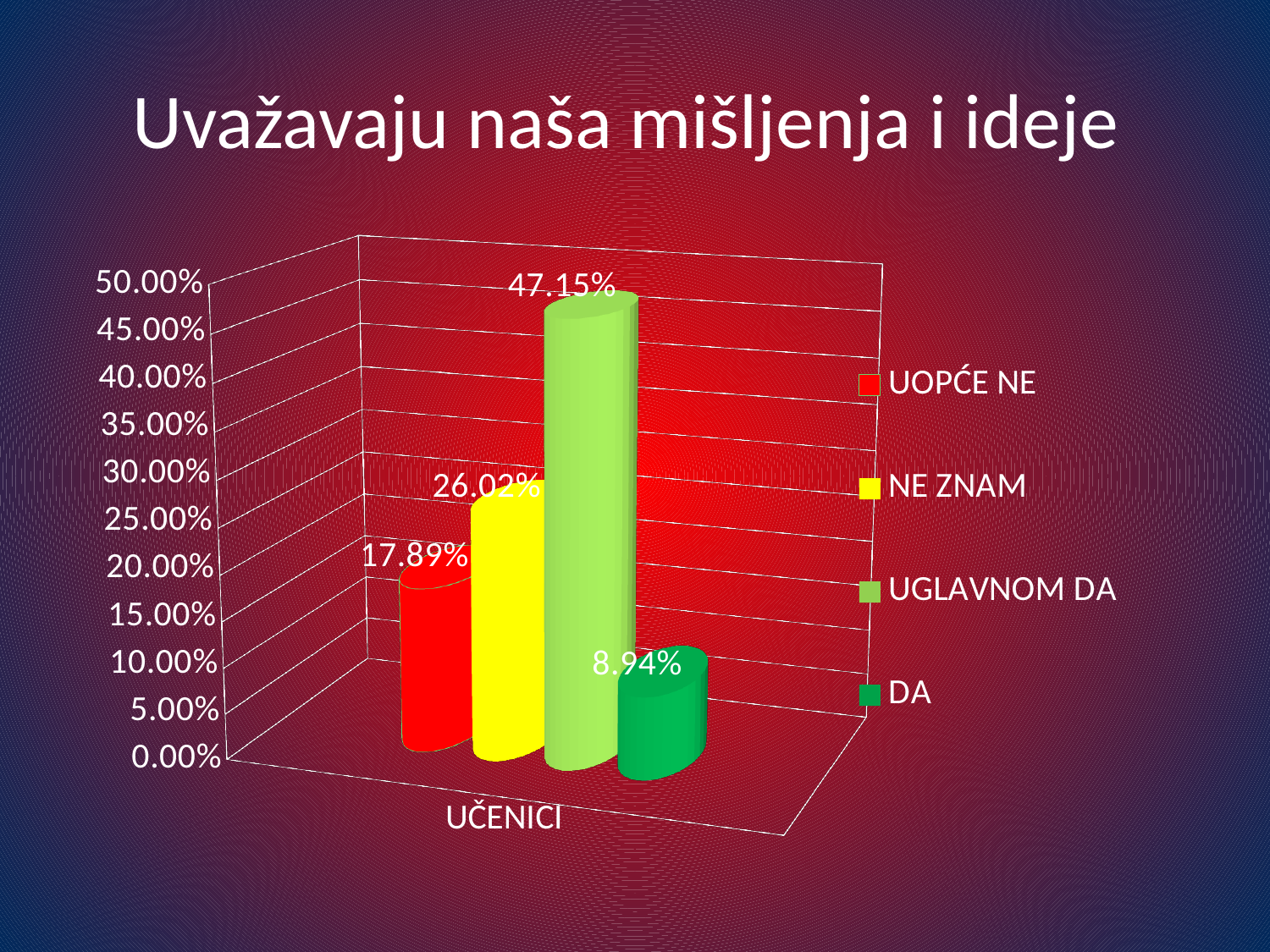
Which is larger, the value for NE ZNAM or the value for UOPĆE NE? NE ZNAM How many series does the legend list? 4 Which series has the lowest value? DA What is the value for NE ZNAM? 26.02% What is the difference between the values for UOPĆE NE and DA? 8.95% What kind of chart is shown on the slide? bar chart What is the difference between the values for UGLAVNOM DA and NE ZNAM? 21.13% Which series has the highest value? UGLAVNOM DA What is the value for DA? 8.94% What is the value for UOPĆE NE? 17.89% What is the value for UGLAVNOM DA? 47.15% What is the title of the chart? Uvažavaju naša mišljenja i ideje